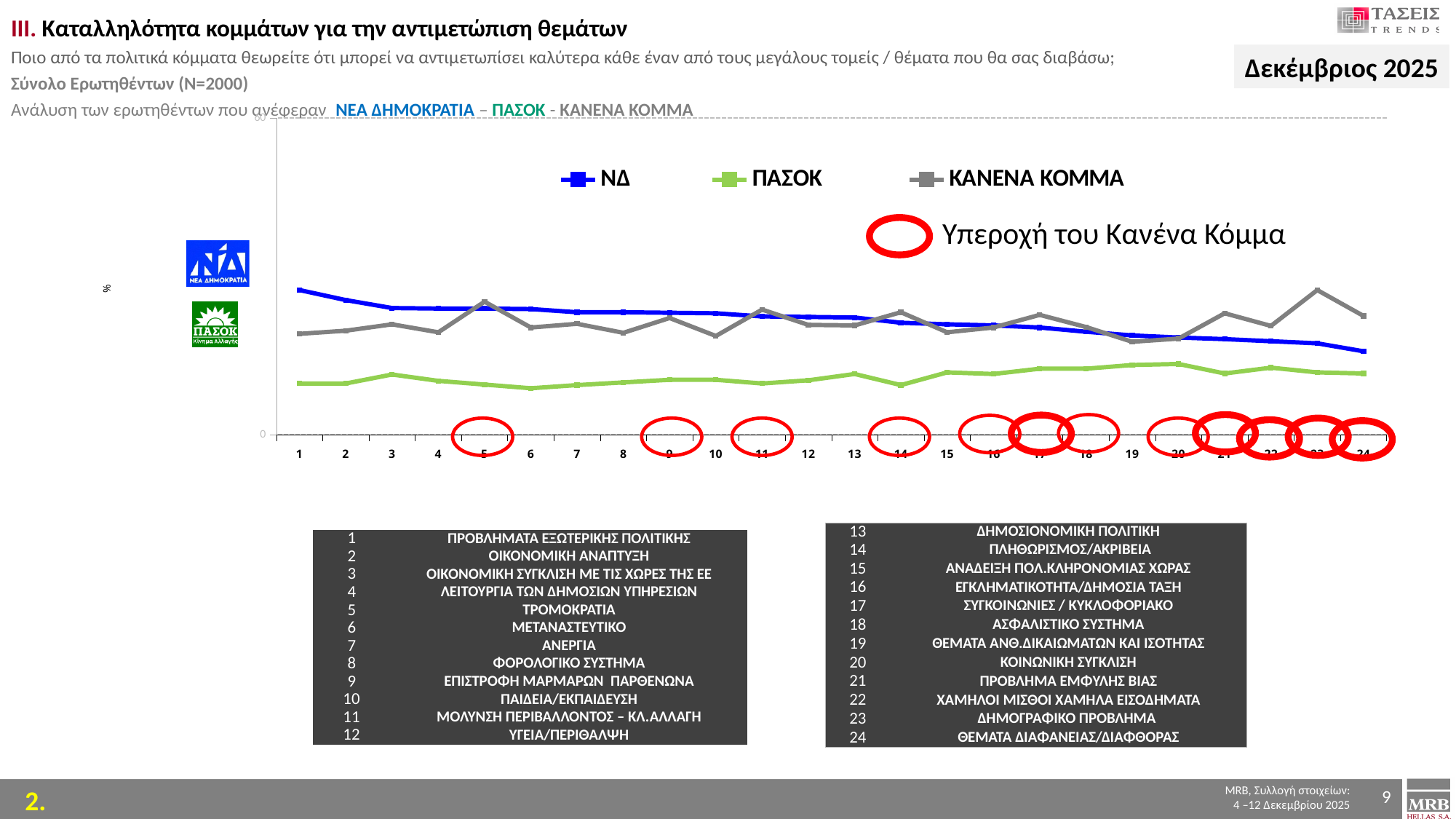
Is the value for ΝΔ at point 1 greater or less than 60? less At point 23, which is larger: the value for ΝΔ or the value for ΚΑΝΕΝΑ ΚΟΜΜΑ? ΚΑΝΕΝΑ ΚΟΜΜΑ What kind of chart is shown on the slide? line chart What colour is the ΚΑΝΕΝΑ ΚΟΜΜΑ line in the chart? grey At point 1, which is larger: the value for ΝΔ or the value for ΚΑΝΕΝΑ ΚΟΜΜΑ? ΝΔ At which x-axis point does the ΝΔ line reach its highest value? 1 How many series does the chart legend list? 3 How many points are plotted along the x axis for each series? 24 At which x-axis point does the ΚΑΝΕΝΑ ΚΟΜΜΑ line reach its highest value? 23 Does the ΝΔ line generally rise or fall from point 1 to point 24? fall At which x-axis point does the ΝΔ line reach its lowest value? 24 Which series is plotted lowest across all 24 points? ΠΑΣΟΚ